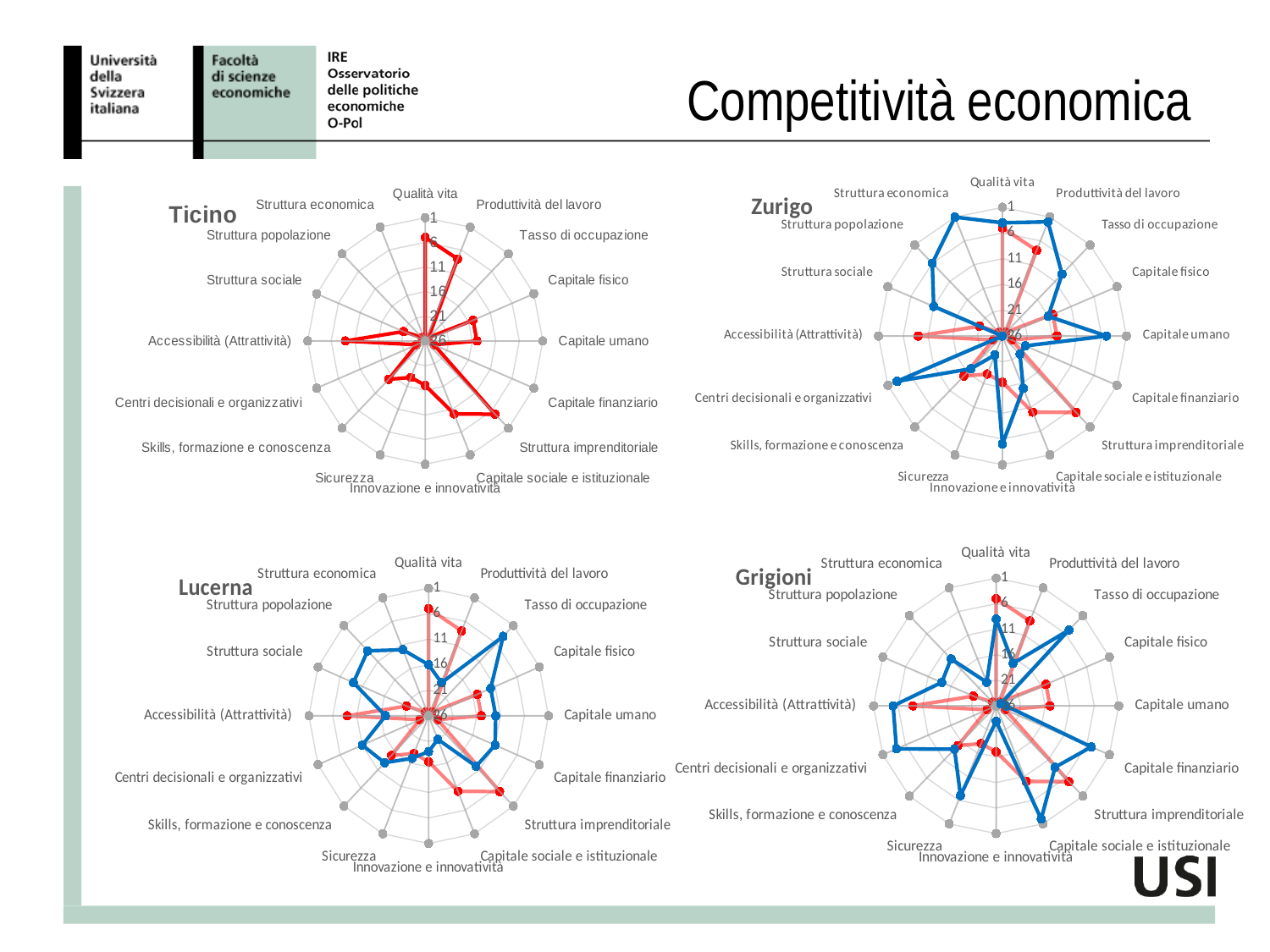
Which four regions are the radar charts labelled with? Ticino, Zurigo, Lucerna, Grigioni In the Zurigo chart, is the blue series value for Capitale umano greater or less than 11? less In the Grigioni chart, what is the lowest tick value printed on the radial axis? 1 In the Ticino chart, is the red series value for Accessibilità (Attrattività) greater or less than 11? less How many radar charts are shown on the slide? 4 In the Ticino chart, is the red series value for Struttura sociale greater or less than 16? greater In the Lucerna chart, what is the highest tick value printed on the radial axis? 26 What kind of chart is used for the Ticino panel? radar chart How many categories (axes) does the Zurigo radar chart have? 16